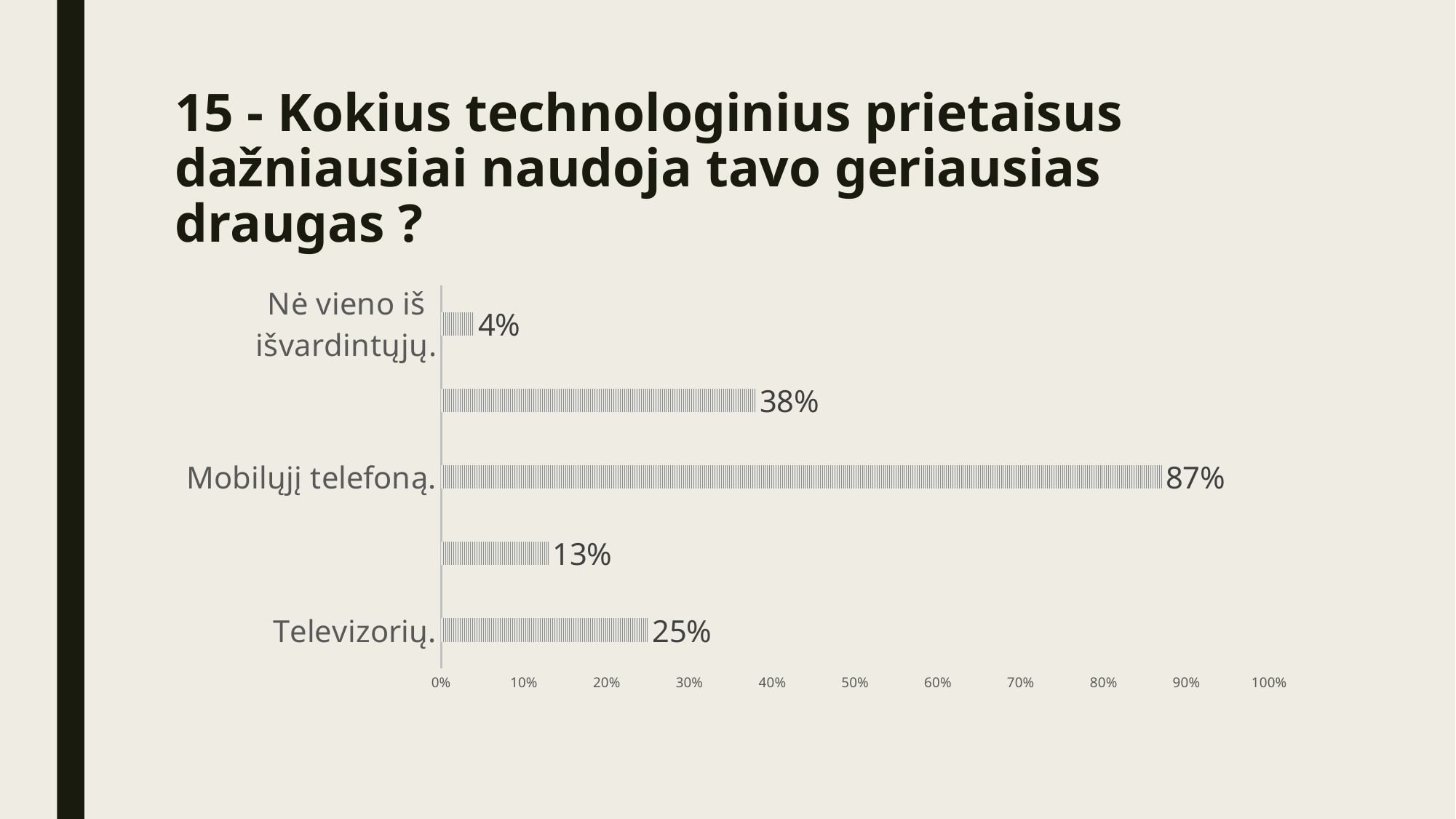
Which is larger, the value for Televizorių. or the value for Nė vieno iš išvardintųjų.? Televizorių. What is the difference between the values for Mobilųjį telefoną. and Televizorių.? 62% What is the value for Mobilųjį telefoną.? 87% What is the value for Televizorių.? 25% Which category has the highest value? Mobilųjį telefoną. Is the value for Mobilųjį telefoną. greater or less than 80%? greater What kind of chart is shown on the slide? bar chart What is the value for Nė vieno iš išvardintųjų.? 4% What is the difference between the values for Televizorių. and Nė vieno iš išvardintųjų.? 21% How many bars are plotted in the chart? 5 Which category has the lowest value? Nė vieno iš išvardintųjų. What is the highest value shown on the horizontal axis? 100%